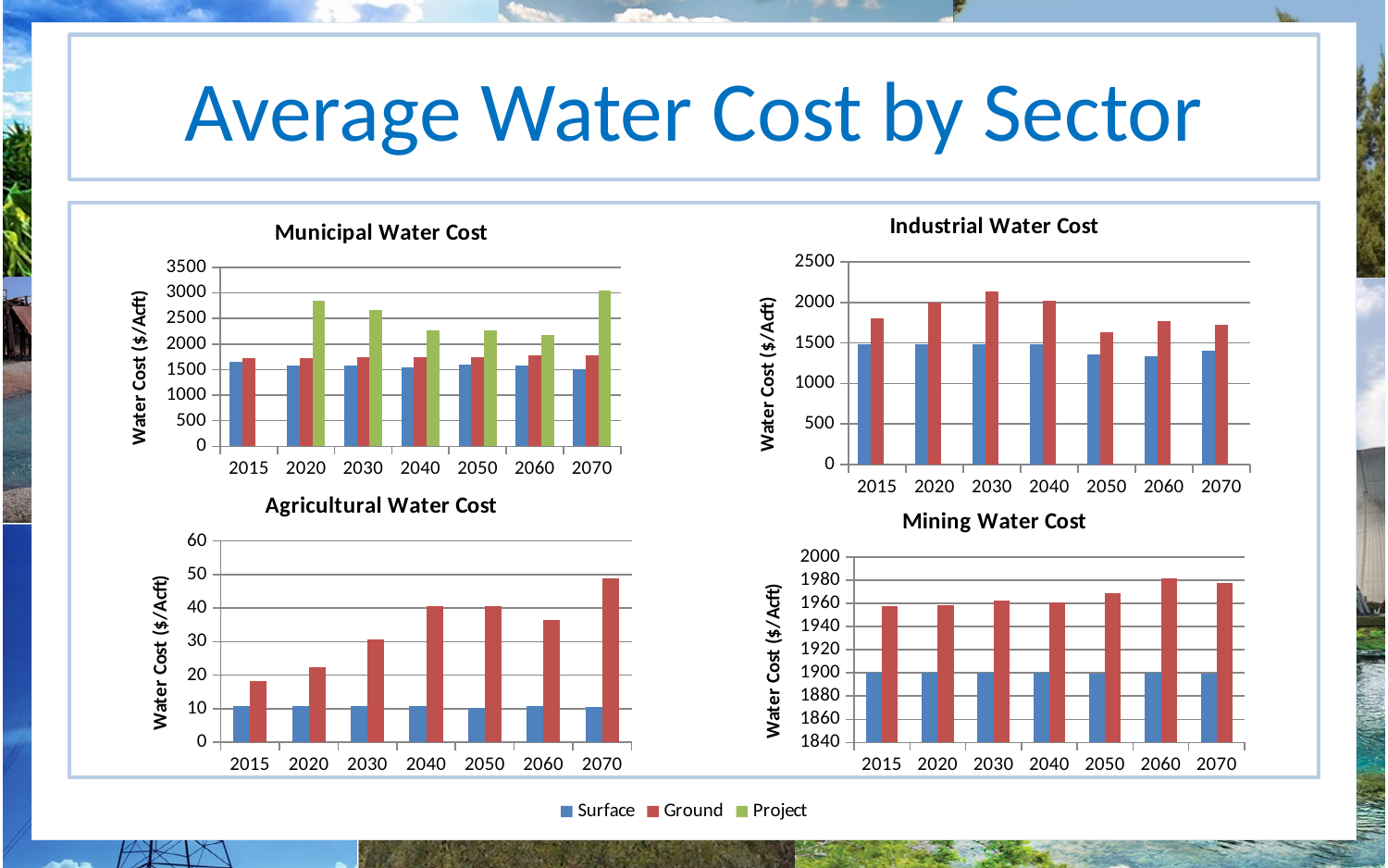
In the Municipal Water Cost chart, is the Project value for 2020 greater or less than 2500? greater In the Industrial Water Cost chart, which year has the highest Ground value? 2030 What type of chart is the Municipal Water Cost chart? bar chart In the Industrial Water Cost chart, which year has the lowest Ground value? 2050 In the Agricultural Water Cost chart, which is larger, the Ground value for 2040 or for 2060? 2040 In the Mining Water Cost chart, what is the Surface value for 2015? 1900 In the Mining Water Cost chart, is the Ground value for 2060 greater or less than 1960? greater In the Municipal Water Cost chart, which year has the highest Project bar? 2070 How many years are shown on the x axis of the Industrial Water Cost chart? 7 How many series does the shared legend at the bottom of the slide list? 3 In the Agricultural Water Cost chart, which year has the highest Ground value? 2070 In the Industrial Water Cost chart, is the Surface value for 2060 greater or less than 1500? less